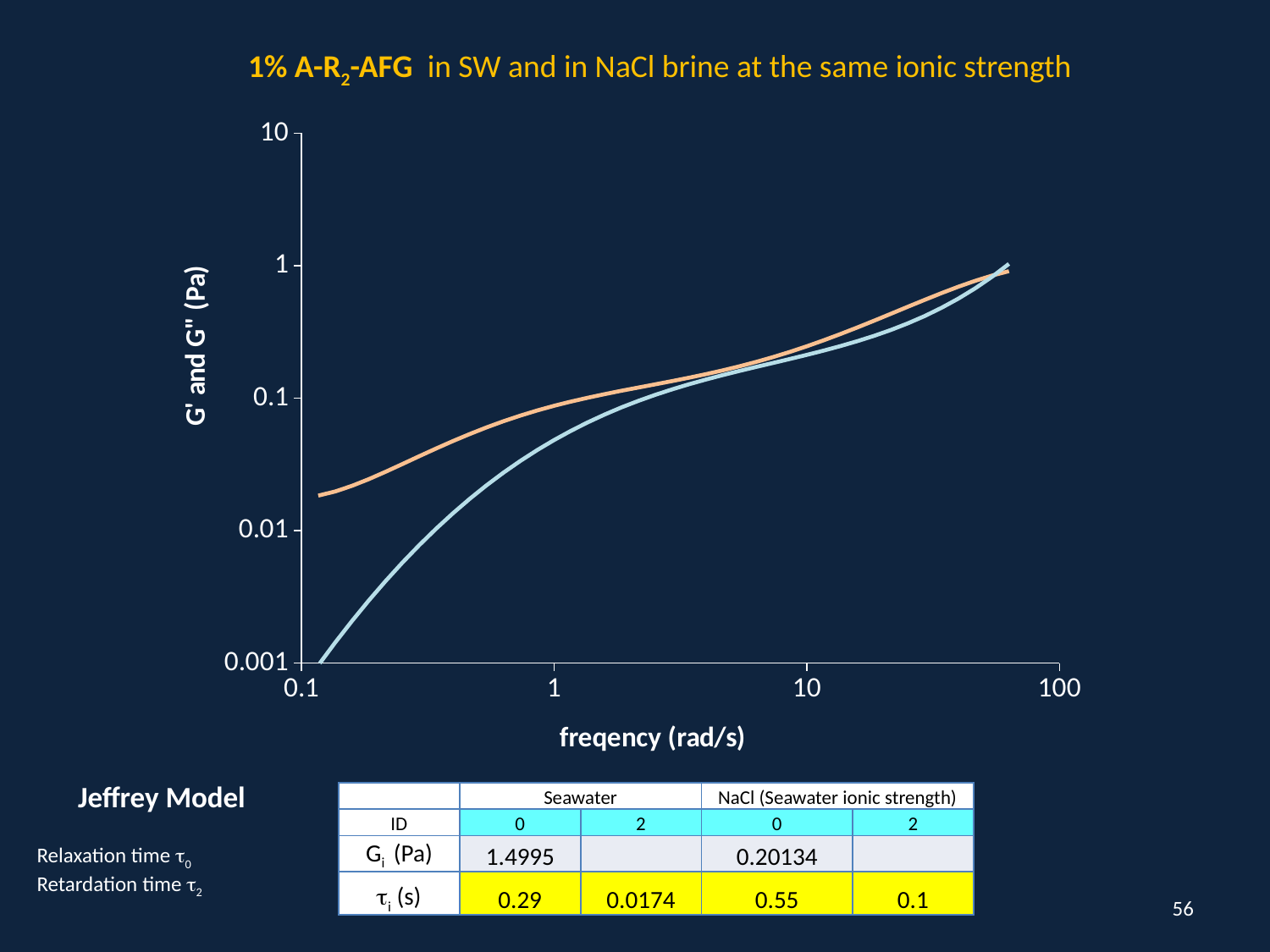
Is the value of the light blue curve at 1 rad/s greater or less than 0.1? less Is the value of the light blue curve at 10 rad/s greater or less than 0.1? greater Is the value of the orange curve at 10 rad/s greater or less than 1? less What is the highest tick value shown on the x axis? 100 At a frequency of 0.1 rad/s, which curve is higher, the orange one or the light blue one? orange What is the label of the y axis of the chart? G' and G'' (Pa) What kind of chart is shown on the slide? line chart What is the label of the x axis of the chart? freqency (rad/s) Do the curves rise or fall as frequency increases along the x axis? rise How many curves are plotted on the chart? 2